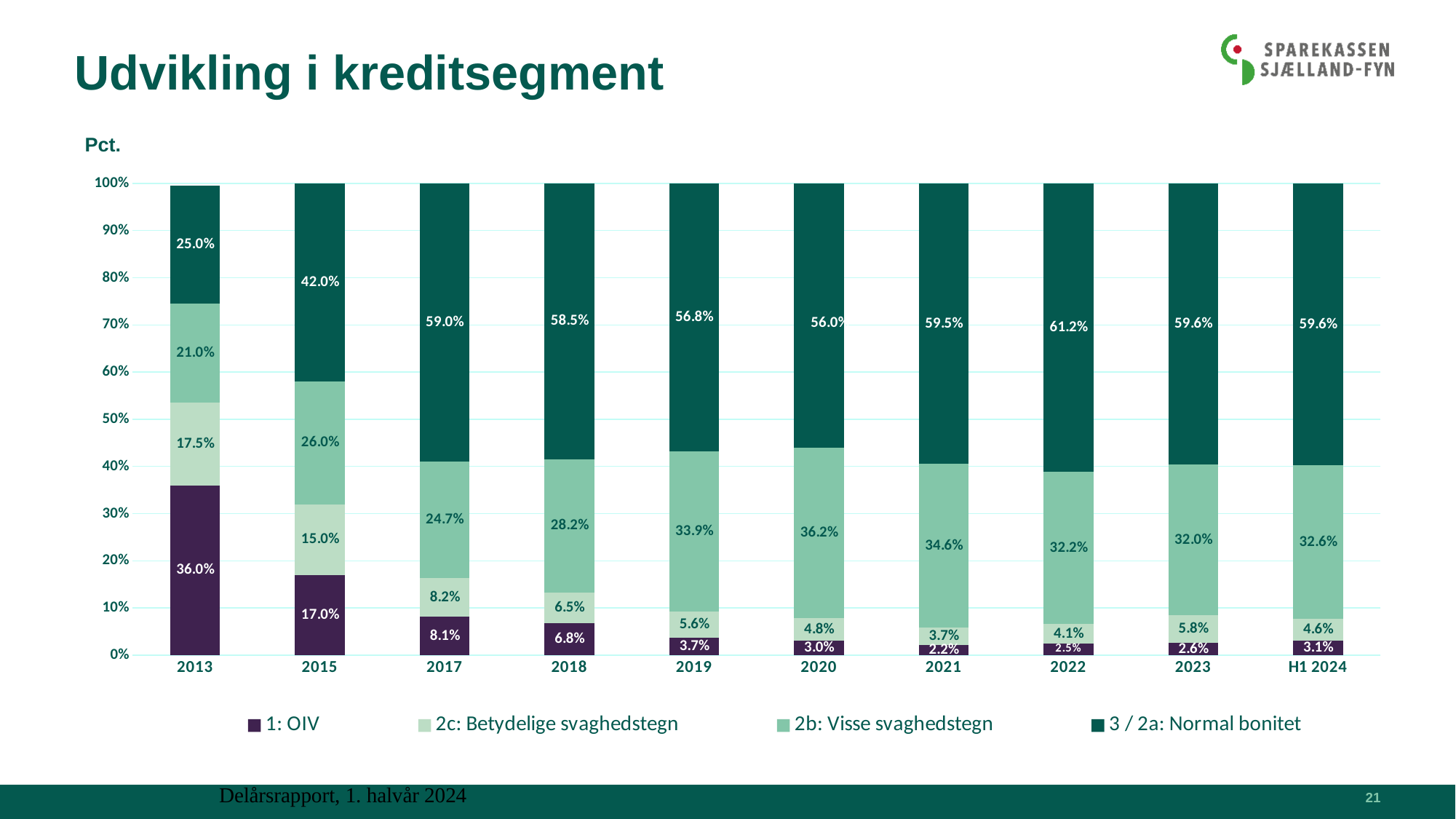
What is the value for '1: OIV' in 2013? 36.0% What is the value for '2c: Betydelige svaghedstegn' in 2019? 5.6% How many series does the legend list? 4 Does the '1: OIV' share generally rise or fall from 2013 to H1 2024? Fall What type of chart is shown on the slide? Stacked bar chart Which is larger: the '2b: Visse svaghedstegn' value in 2020 or in 2021? 2020 In which year is the '3 / 2a: Normal bonitet' share lowest? 2013 What is the value for '2b: Visse svaghedstegn' in H1 2024? 32.6% What is the difference between the '3 / 2a: Normal bonitet' values in 2015 and 2013? 17.0% What is the value for '3 / 2a: Normal bonitet' in 2022? 61.2% How many categories are shown on the x axis? 10 In which year is the '1: OIV' share highest? 2013